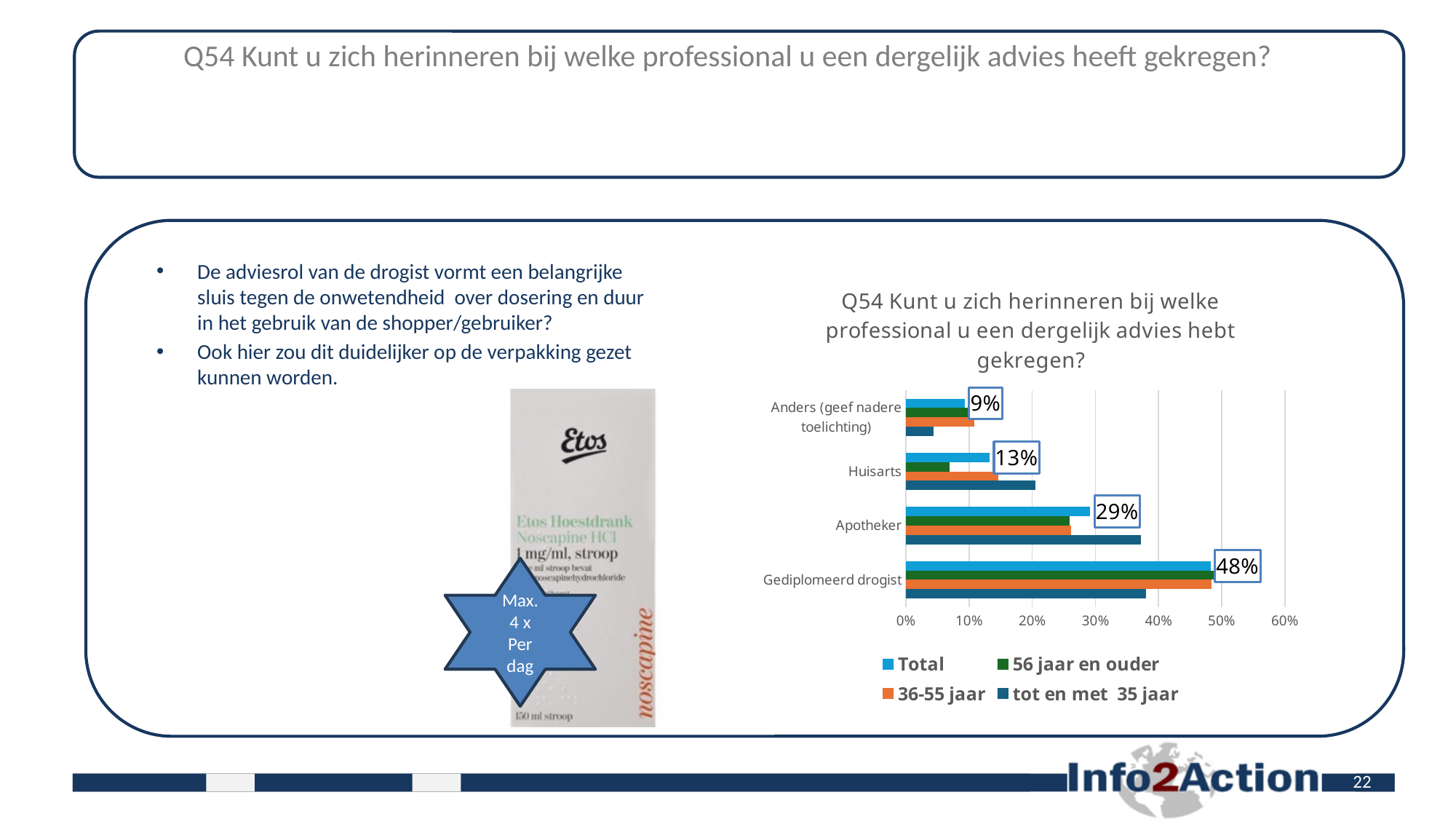
What is the Total value for Apotheker? 29% How many series does the legend list? 4 What is the Total value for Huisarts? 13% Which has a larger Total value, Apotheker or Huisarts? Apotheker What is the difference between the Total values for Gediplomeerd drogist and Apotheker? 19 percentage points Which category has the lowest Total value? Anders (geef nadere toelichting) What is the Total value for Anders (geef nadere toelichting)? 9% Is the value for 'tot en met 35 jaar' at Anders (geef nadere toelichting) greater or less than 10%? less Is the value for 'tot en met 35 jaar' at Gediplomeerd drogist greater or less than 30%? greater What is the Total value for Gediplomeerd drogist? 48% What kind of chart is shown on the slide? Bar chart Which category has the highest Total value? Gediplomeerd drogist